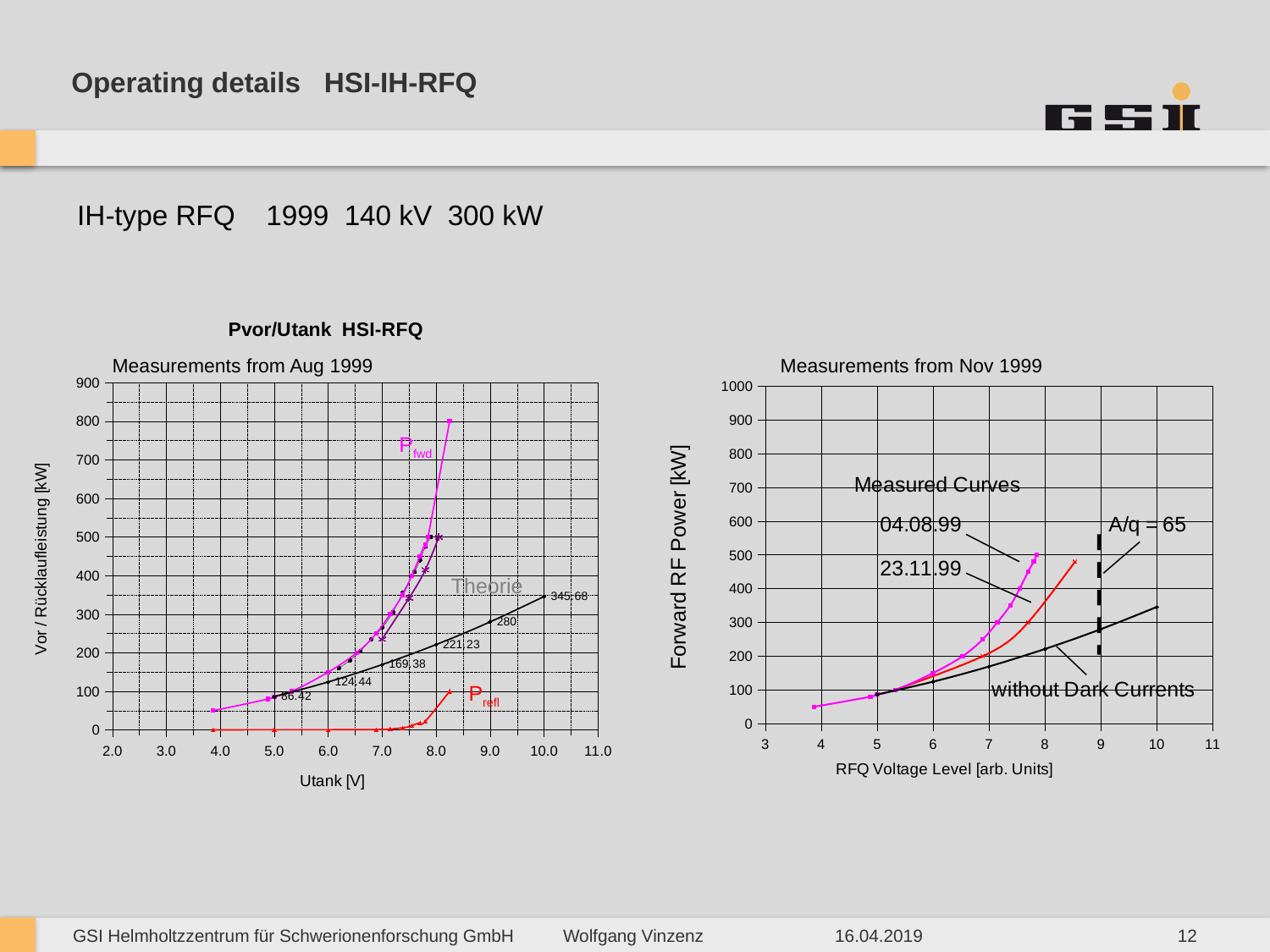
In the right chart (Measurements from Nov 1999), at which RFQ Voltage Level is the dashed A/q = 65 line drawn? 9 In the left chart (Measurements from Aug 1999), what is the difference between the Theorie values at Utank 10.0 V and 9.0 V? 65.68 In the left chart (Measurements from Aug 1999), is the highest value of the P fwd curve greater or less than 700? greater In the left chart (Measurements from Aug 1999), what is the Theorie value at Utank 9.0 V? 280 In the left chart (Measurements from Aug 1999), what is the Theorie value at Utank 5.0 V? 86.42 What is the x-axis label of the left chart (Measurements from Aug 1999)? Utank [V] In the right chart (Measurements from Nov 1999), is the value of the 'without Dark Currents' curve at RFQ Voltage Level 10 greater or less than 400? less In the left chart (Measurements from Aug 1999), what is the Theorie value at Utank 6.0 V? 124.44 In the left chart (Measurements from Aug 1999), what is the Theorie value at Utank 10.0 V? 345.68 What is the y-axis label of the right chart (Measurements from Nov 1999)? Forward RF Power [kW] In the right chart (Measurements from Nov 1999), does the 'without Dark Currents' curve rise or fall as the RFQ Voltage Level increases? rise What kind of chart is the left chart titled 'Measurements from Aug 1999'? line chart